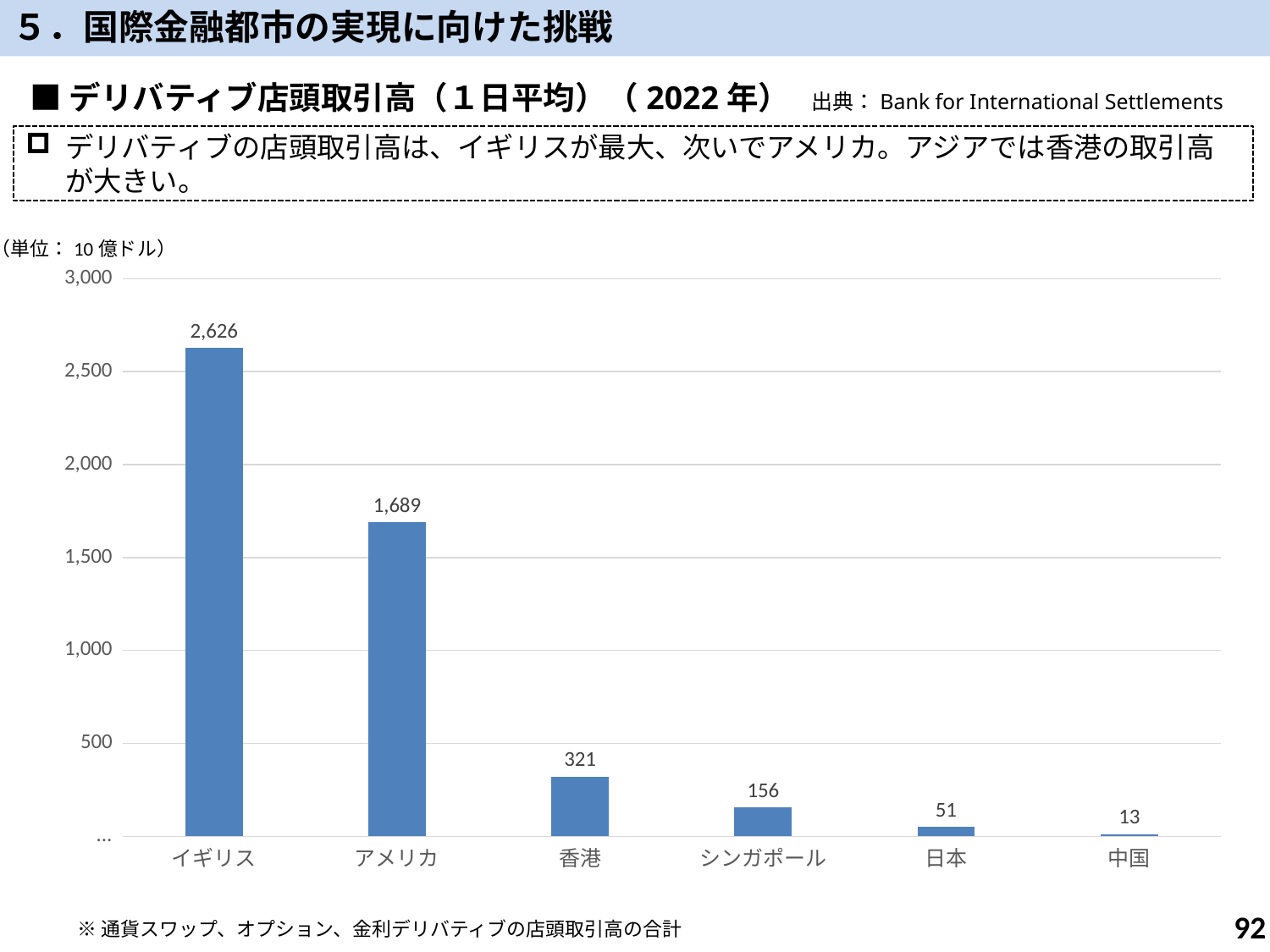
What kind of chart is shown on the slide? bar chart What is the value for 日本? 51 What is the difference between the values for 香港 and シンガポール? 165 How many categories are shown on the x axis? 6 What is the value for イギリス? 2,626 Which is larger, the value for シンガポール or the value for 日本? シンガポール Which category has the lowest value? 中国 Is the value for アメリカ greater or less than 1,500? greater Which category has the highest value? イギリス What unit is stated for the values in the chart? 10億ドル What is the difference between the values for イギリス and アメリカ? 937 What is the value for 香港? 321